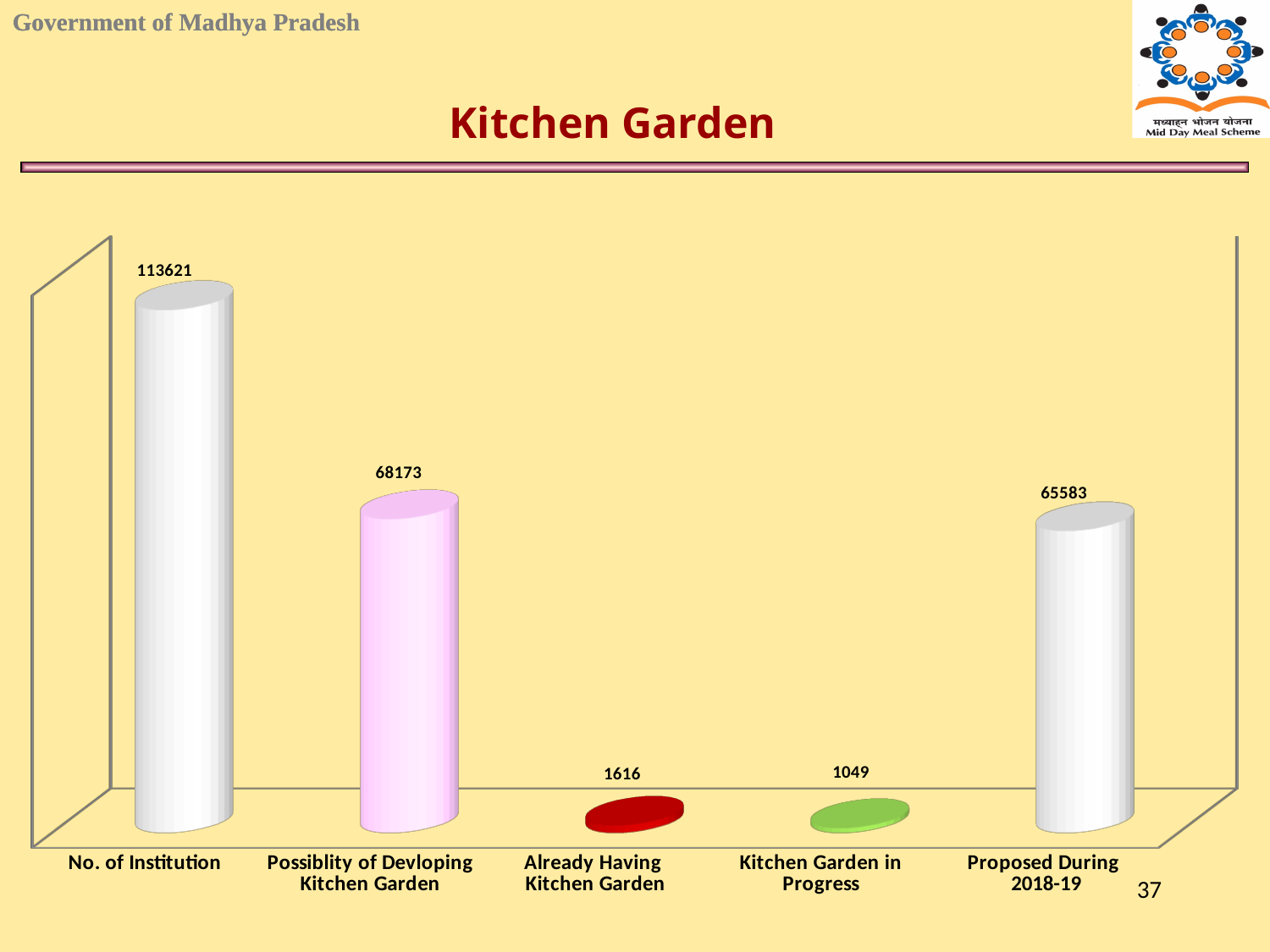
What is the value for No. of Institution? 113621 Which category has the highest value? No. of Institution Which category has the lowest value? Kitchen Garden in Progress Which is larger, Possiblity of Devloping Kitchen Garden or Proposed During 2018-19? Possiblity of Devloping Kitchen Garden How many categories are shown in the chart? 5 What is the value for Possiblity of Devloping Kitchen Garden? 68173 What is the difference between Already Having Kitchen Garden and Kitchen Garden in Progress? 567 What is the difference between Possiblity of Devloping Kitchen Garden and Proposed During 2018-19? 2590 What kind of chart is shown on the slide? Bar chart What is the value for Already Having Kitchen Garden? 1616 What is the value for Proposed During 2018-19? 65583 What is the value for Kitchen Garden in Progress? 1049